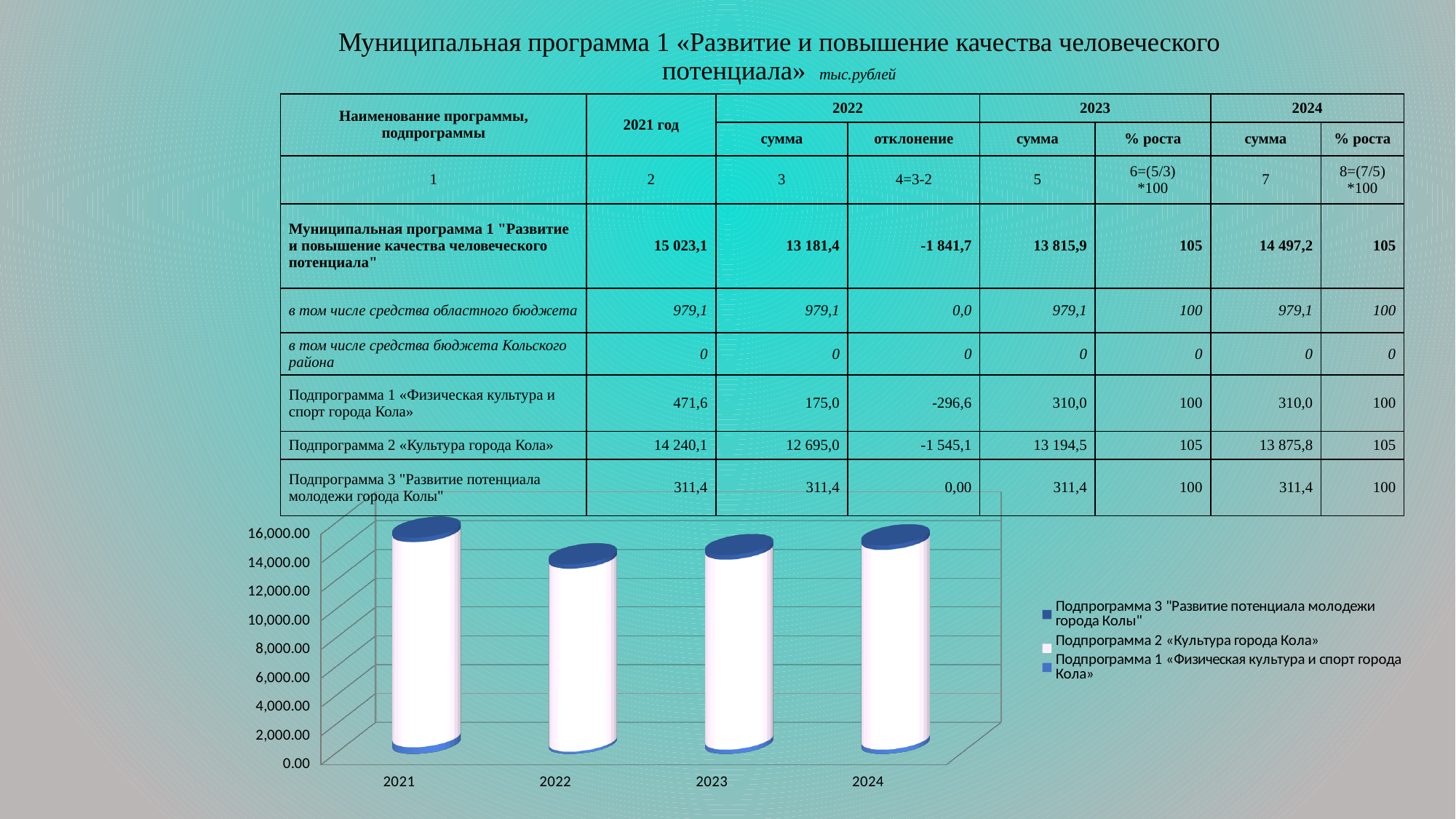
What kind of chart is shown at the bottom of the slide? Stacked bar chart Does the total height of the stacked bars rise or fall from 2022 to 2024? rise Is the total of the stacked bar for 2022 greater or less than 10,000.00? greater In the chart, is the stacked bar for 2021 or for 2024 taller? 2021 Is the total of the stacked bar for 2021 greater or less than 8,000.00? greater In the chart, is the stacked bar for 2023 or for 2024 taller? 2024 How many years are shown on the x axis of the chart? 4 Which year has the shortest stacked bar in the chart? 2022 Which year has the tallest stacked bar in the chart? 2021 Which series in the legend is shown in white in the chart? Подпрограмма 2 «Культура города Кола» How many series does the chart legend list? 3 Does the total height of the stacked bars rise or fall from 2021 to 2022? fall